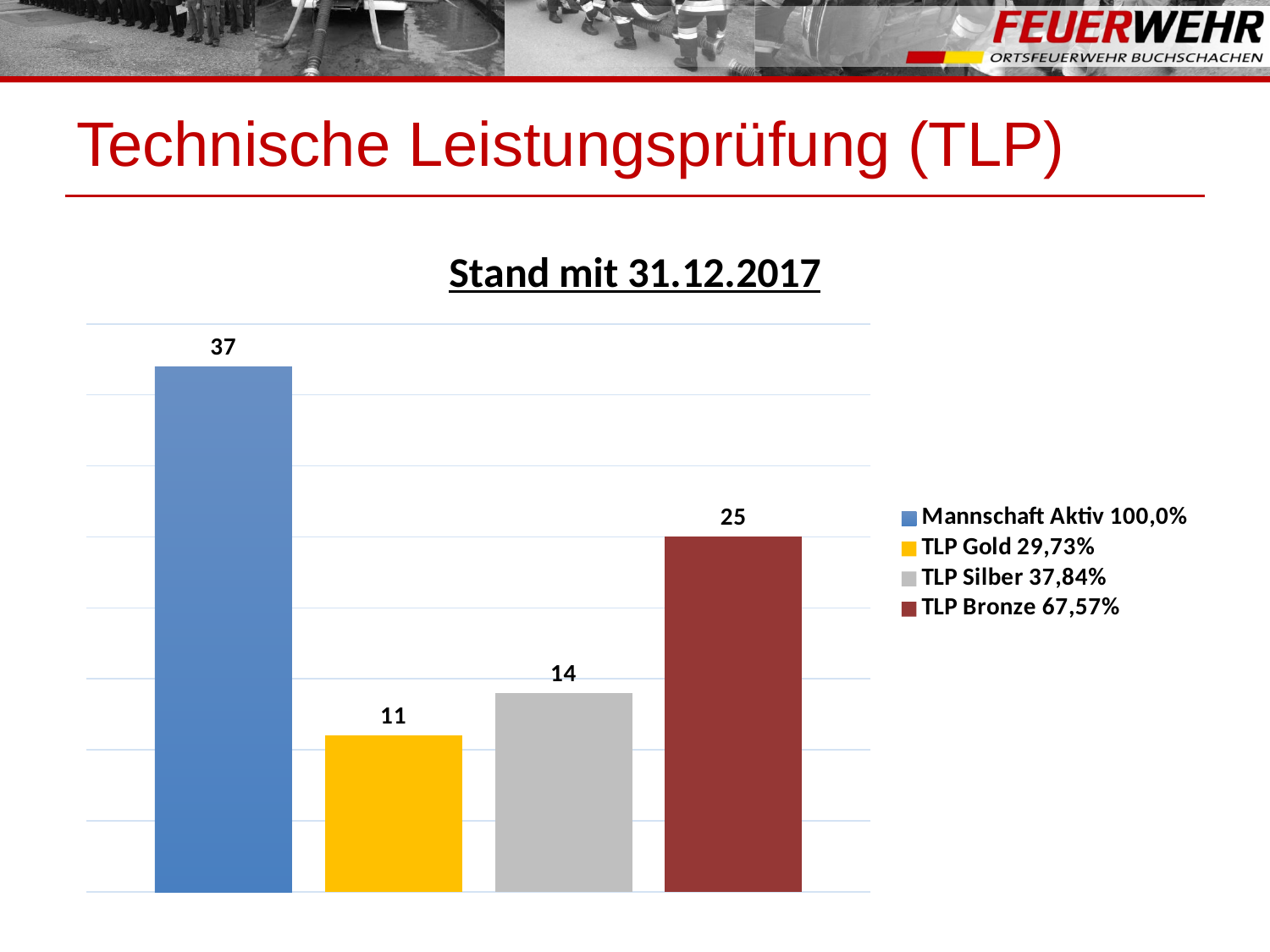
What percentage is shown in the legend for TLP Bronze? 67,57% What is the difference between the values for TLP Silber and TLP Gold? 3 What is the value for TLP Gold? 11 How many bars are shown in the chart? 4 What is the difference between the values for Mannschaft Aktiv and TLP Bronze? 12 Which category has the highest value? Mannschaft Aktiv What is the value for Mannschaft Aktiv? 37 What is the value for TLP Bronze? 25 What is the value for TLP Silber? 14 What kind of chart is shown on the slide? Bar chart Which is larger, the value for TLP Bronze or the value for TLP Silber? TLP Bronze Which category has the lowest value? TLP Gold